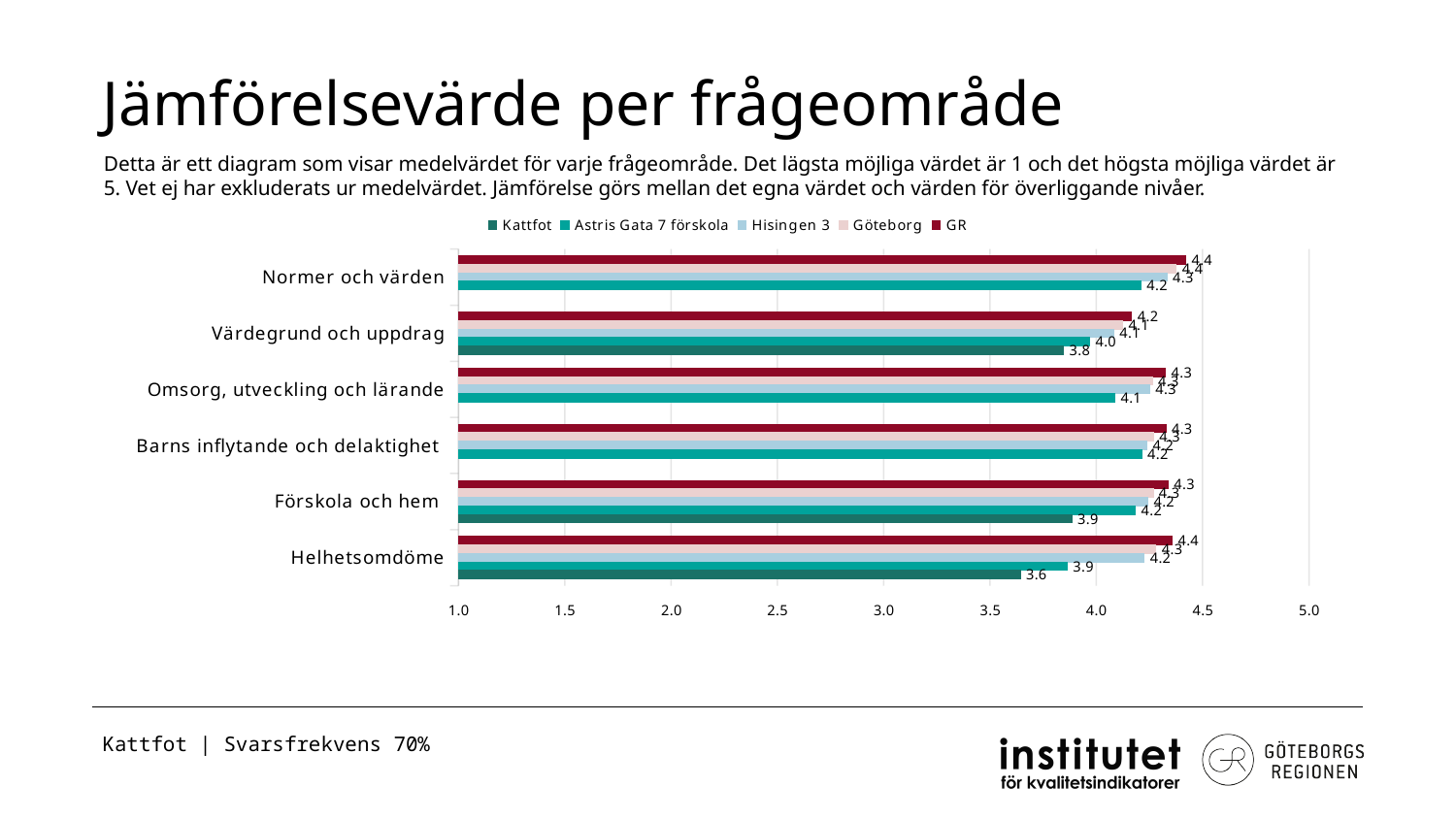
How many series does the legend of the chart list? 5 What is the value for Astris Gata 7 förskola in the category Helhetsomdöme? 3.9 What is the value for Kattfot in the category Helhetsomdöme? 3.6 In which category does Kattfot have its lowest value? Helhetsomdöme What is the value for Kattfot in the category Värdegrund och uppdrag? 3.8 Which is larger for Astris Gata 7 förskola: the value for Normer och värden or the value for Helhetsomdöme? Normer och värden What kind of chart is shown on the slide? Bar chart What is the value for GR in the category Normer och värden? 4.4 What is the difference between the GR value and the Kattfot value in the category Helhetsomdöme? 0.8 What is the value for Astris Gata 7 förskola in the category Värdegrund och uppdrag? 4.0 Is the value for Kattfot in the category Förskola och hem greater or less than 4.0? less How many question areas (categories) are shown on the y axis of the chart? 6